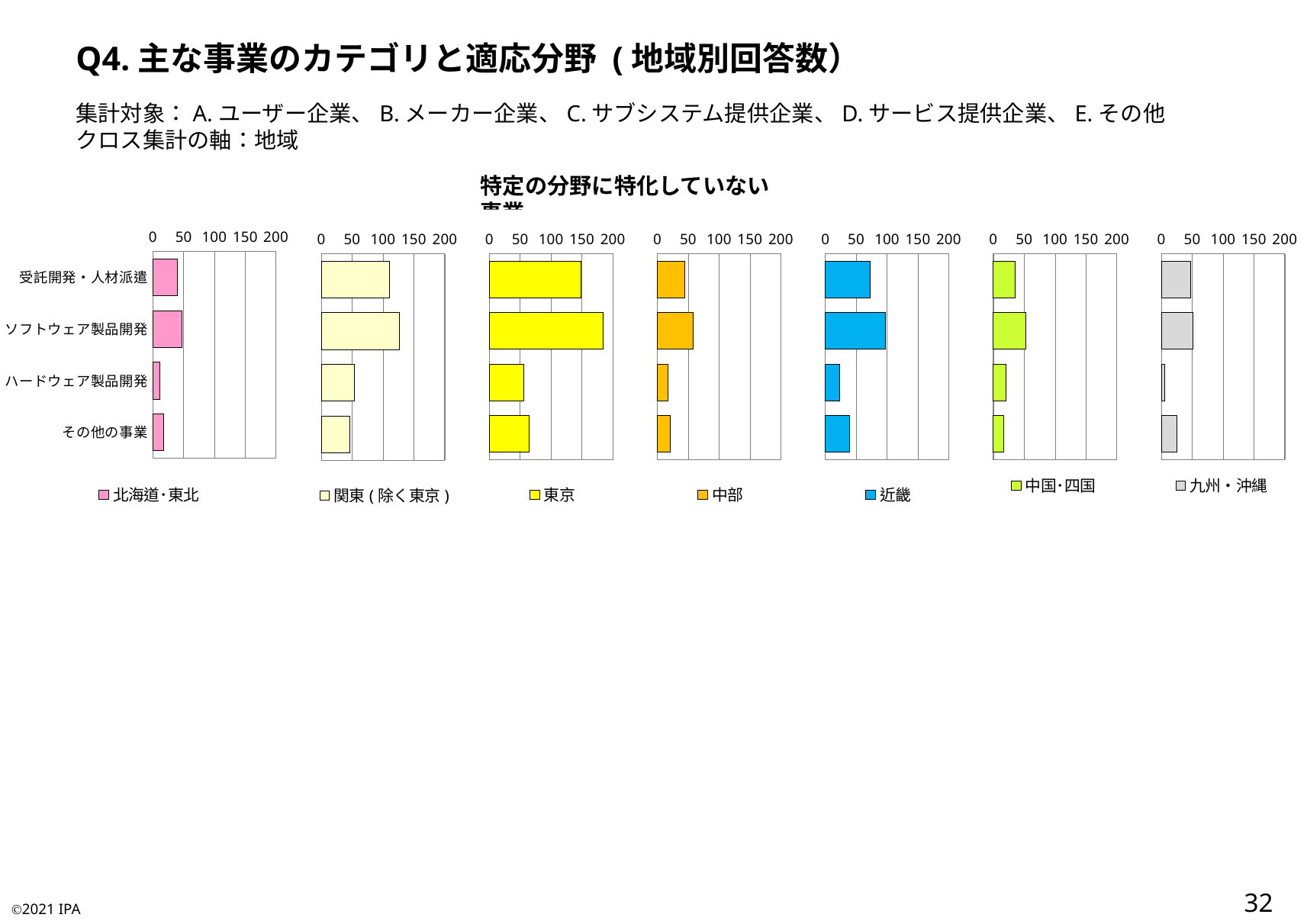
What kind of chart is used for each region on this slide? bar chart In the 近畿 chart, which is larger, 受託開発・人材派遣 or その他の事業? 受託開発・人材派遣 In the 九州・沖縄 chart, which category has the lowest value? ハードウェア製品開発 In the 九州・沖縄 chart, is the value for ハードウェア製品開発 greater or less than 50? less In the 東京 chart, which category has the highest value? ソフトウェア製品開発 In the 関東(除く東京) chart, is the value for ソフトウェア製品開発 greater or less than 100? greater In the 東京 chart, is the value for 受託開発・人材派遣 greater or less than 100? greater Which region does the blue bar chart represent according to its legend? 近畿 In the 関東(除く東京) chart, which is larger, ソフトウェア製品開発 or ハードウェア製品開発? ソフトウェア製品開発 How many regional charts are shown on the slide? 7 How many business categories are listed on the vertical axis of the charts? 4